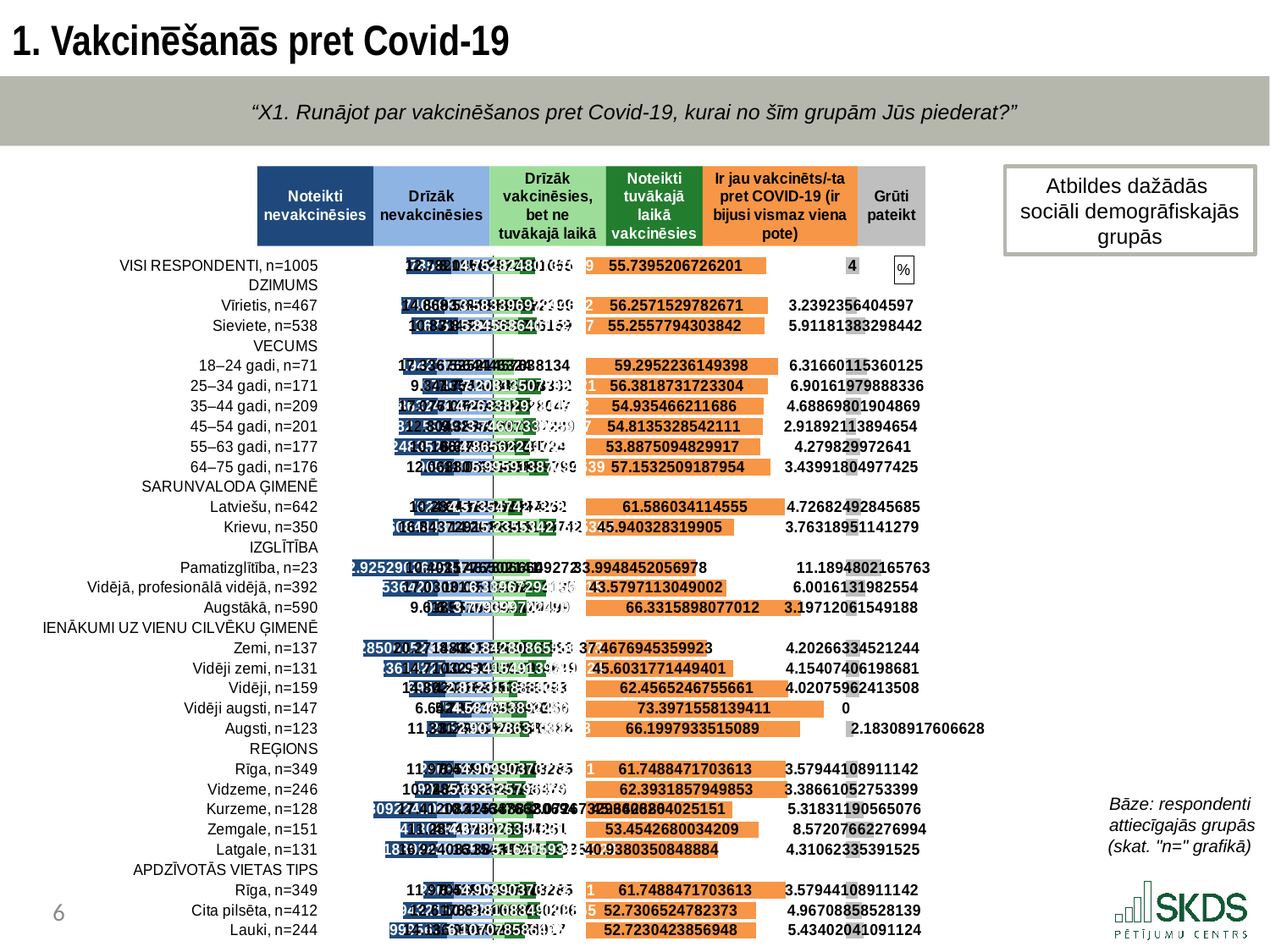
Among the income groups (IENĀKUMI UZ VIENU CILVĒKU ĢIMENĒ), which has the highest "Ir jau vakcinēts/-ta pret COVID-19" value? Vidēji augsti, n=147 What is the value of "Ir jau vakcinēts/-ta pret COVID-19 (ir bijusi vismaz viena pote)" for VISI RESPONDENTI, n=1005? 55.7395206726201 How many series does the legend list? 6 What is the "Grūti pateikt" value for Vidēji augsti, n=147? 0 What survey question is quoted above the chart? "X1. Runājot par vakcinēšanos pret Covid-19, kurai no šīm grupām Jūs piederat?" What is the difference between the "Ir jau vakcinēts/-ta pret COVID-19" values for Latviešu, n=642 and Krievu, n=350? 15.64570579465 Among the education groups (IZGLĪTĪBA), which has the lowest "Ir jau vakcinēts/-ta pret COVID-19" value? Pamatizglītība, n=23 Which region (REĢIONS) has the highest "Grūti pateikt" value? Zemgale, n=151 Which has a larger "Ir jau vakcinēts/-ta pret COVID-19" value: Latviešu, n=642 or Krievu, n=350? Latviešu, n=642 What is the value of "Ir jau vakcinēts/-ta pret COVID-19" for Augstākā, n=590? 66.3315898077012 What is the "Grūti pateikt" value for VISI RESPONDENTI, n=1005? 4 What kind of chart is shown on the slide? stacked bar chart